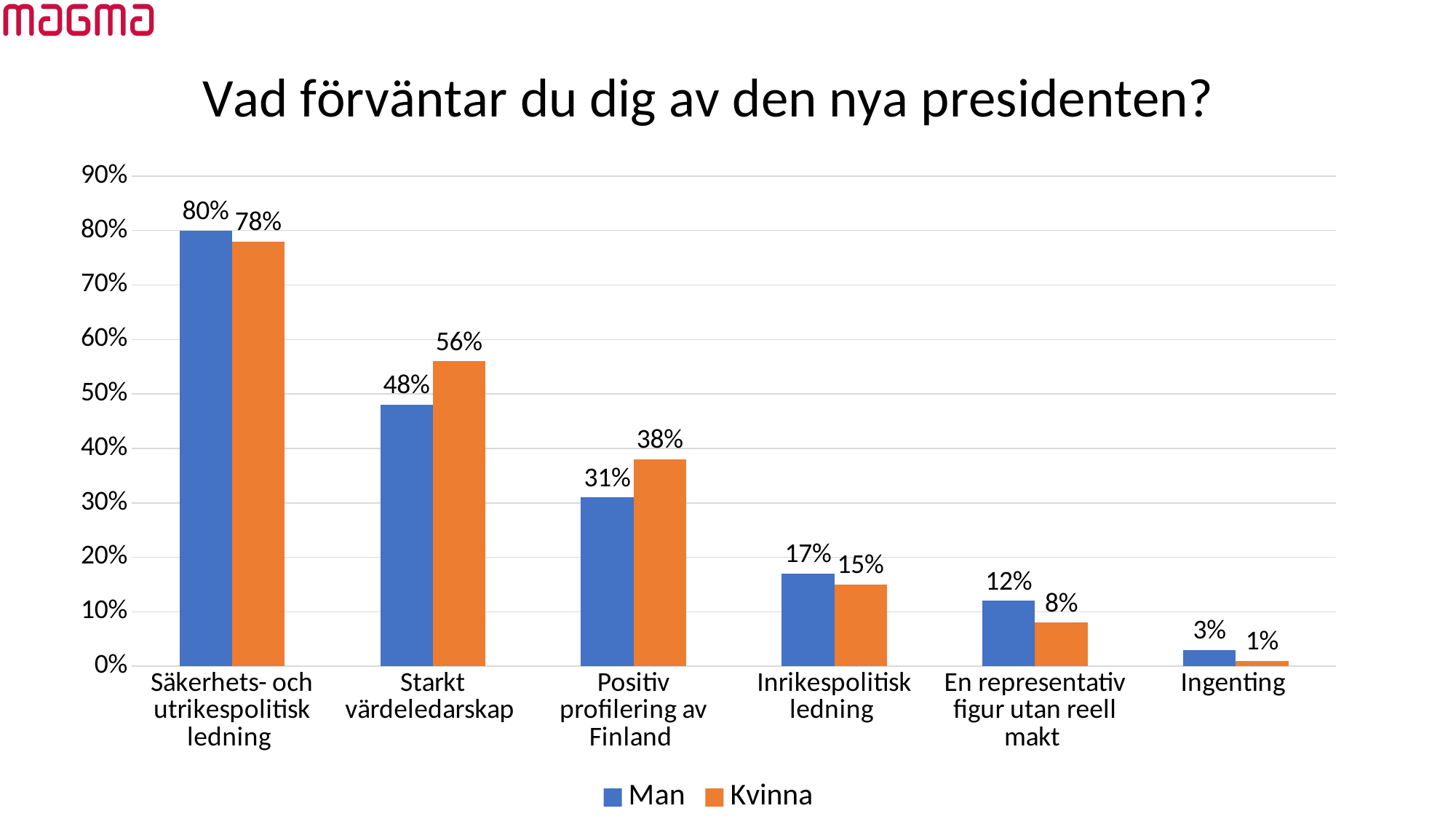
Which category has the lowest value for Kvinna? Ingenting In the 'Inrikespolitisk ledning' category, which series has the larger value, Man or Kvinna? Man How many categories are shown on the x axis? 6 Which category has the highest value for Man? Säkerhets- och utrikespolitisk ledning What is the difference between the Kvinna and Man values in the 'Starkt värdeledarskap' category? 8% What is the value for Kvinna in the 'Positiv profilering av Finland' category? 38% What is the value for Man in the 'Starkt värdeledarskap' category? 48% How many series does the legend list? 2 What is the difference between the Man and Kvinna values in the 'En representativ figur utan reell makt' category? 4% What kind of chart is shown on the slide? Bar chart What is the value for Kvinna in the 'Ingenting' category? 1% What is the title of the chart? Vad förväntar du dig av den nya presidenten?